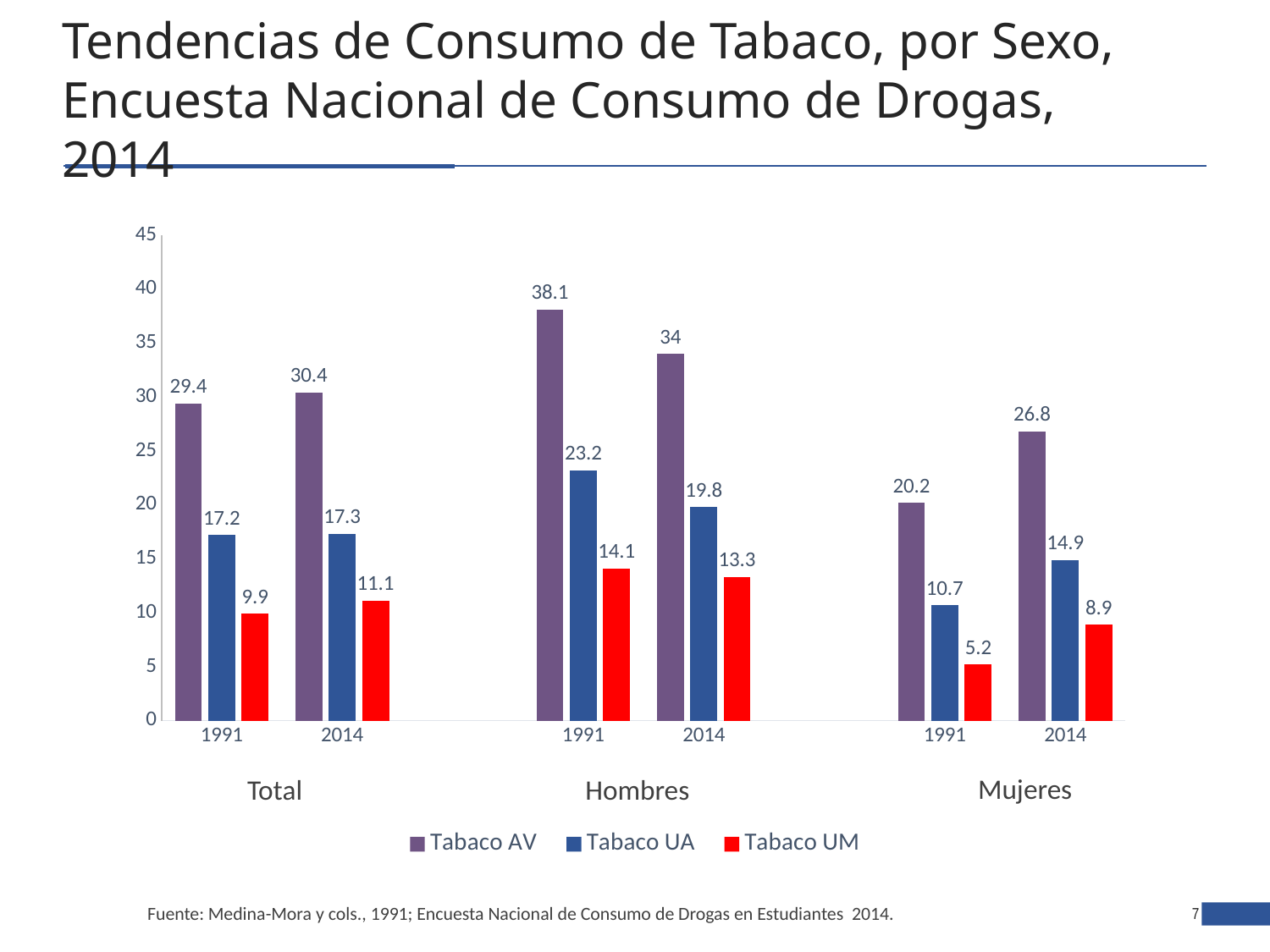
What is the difference between the Tabaco UM values for Mujeres in 2014 and 1991? 3.7 Which is larger, Tabaco UA for Hombres in 1991 or Tabaco UA for Mujeres in 2014? Tabaco UA for Hombres in 1991 What colour are the Tabaco UM bars? Red Which group and year has the highest Tabaco AV value? Hombres 1991 What kind of chart is shown on the slide? Bar chart What is the value of Tabaco UA for Total in 2014? 17.3 What is the value of Tabaco UM for Mujeres in 2014? 8.9 Does the Tabaco AV value for Mujeres rise or fall from 1991 to 2014? Rise How many series does the legend list? 3 What is the value of Tabaco AV for Hombres in 1991? 38.1 What is the difference between the Tabaco AV values for Hombres in 1991 and 2014? 4.1 Which group and year has the lowest Tabaco UM value? Mujeres 1991